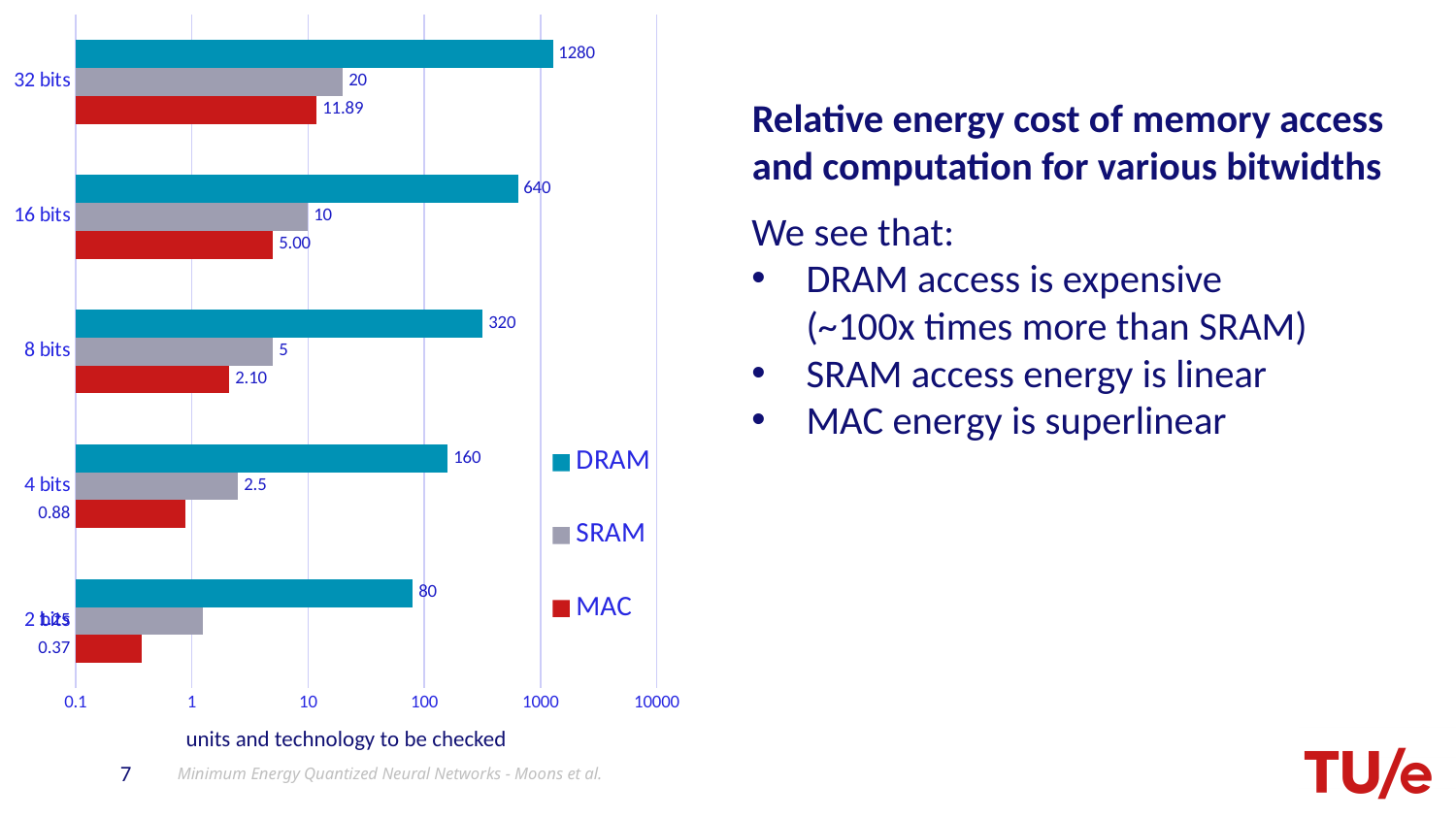
Which bitwidth has the lowest MAC value? 2 bits Which bitwidth has the highest DRAM value? 32 bits What is the MAC value for 16 bits? 5.00 What is the DRAM value for 32 bits? 1280 What is the SRAM value for 4 bits? 2.5 How many bitwidth categories are shown on the chart? 5 Which is larger for 8 bits, the SRAM value or the MAC value? SRAM What is the difference between the DRAM values for 16 bits and 8 bits? 320 What kind of chart is shown on the slide? bar chart What is the MAC value for 2 bits? 0.37 Is the DRAM value for 4 bits greater or less than 100? greater How many series does the legend list? 3